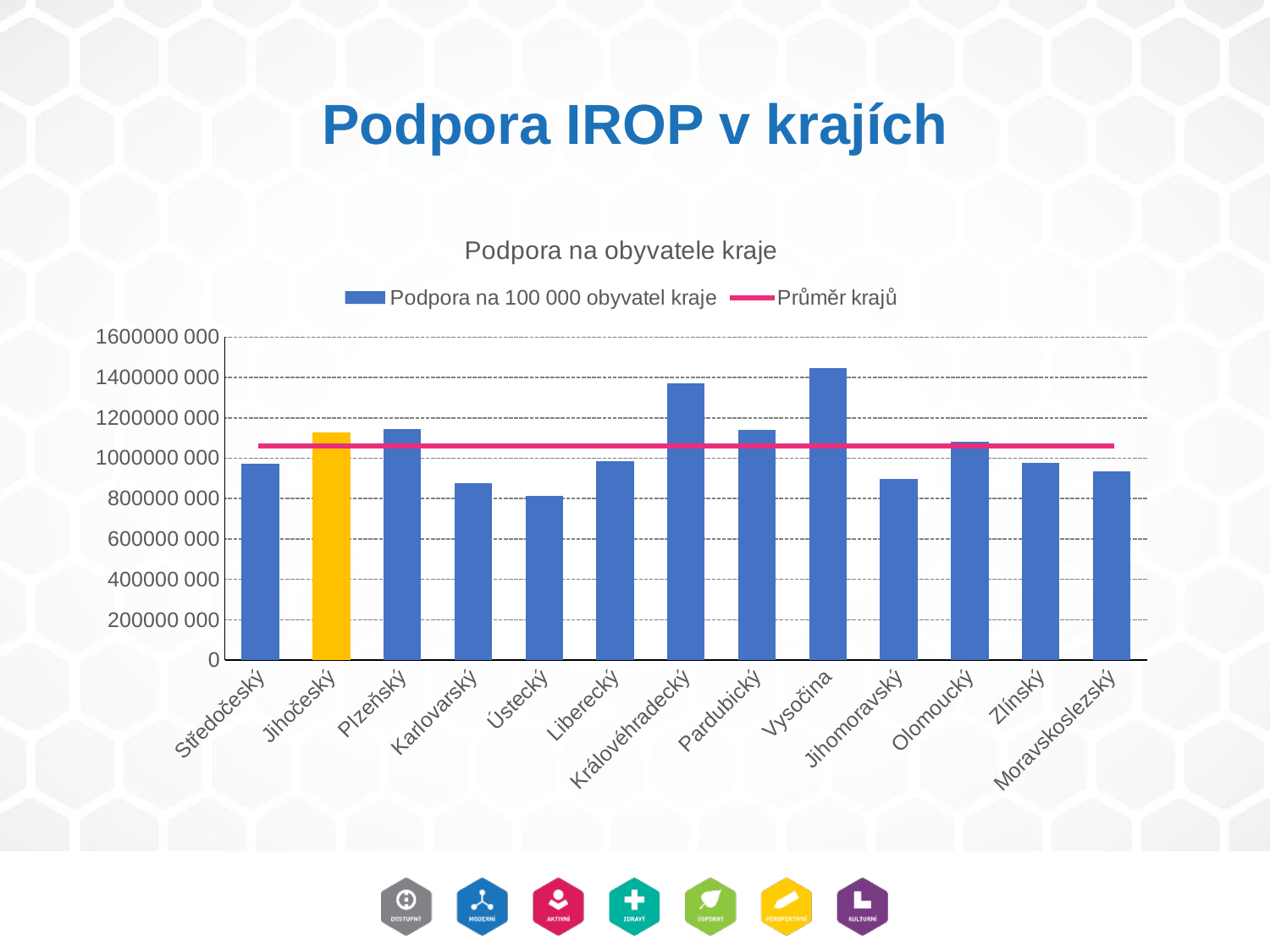
Which region has the highest value for Podpora na 100 000 obyvatel kraje? Vysočina What is the title of the chart? Podpora na obyvatele kraje How many regions (categories) are shown on the x axis of the chart? 13 What kind of chart is shown on the slide? combination bar and line chart (bars with an average line) Which region's bar is highlighted in a different colour (yellow) from the others? Jihočeský Is the value for Karlovarský greater or less than 800000 000? greater How many series does the chart legend list? 2 Which region has the lowest value for Podpora na 100 000 obyvatel kraje? Ústecký Is the value for Vysočina greater or less than 1400000 000? greater Which has a larger value, Jihomoravský or Pardubický? Pardubický Which has a larger value, Královéhradecký or Karlovarský? Královéhradecký Is the value for Ústecký greater or less than 1000000 000? less